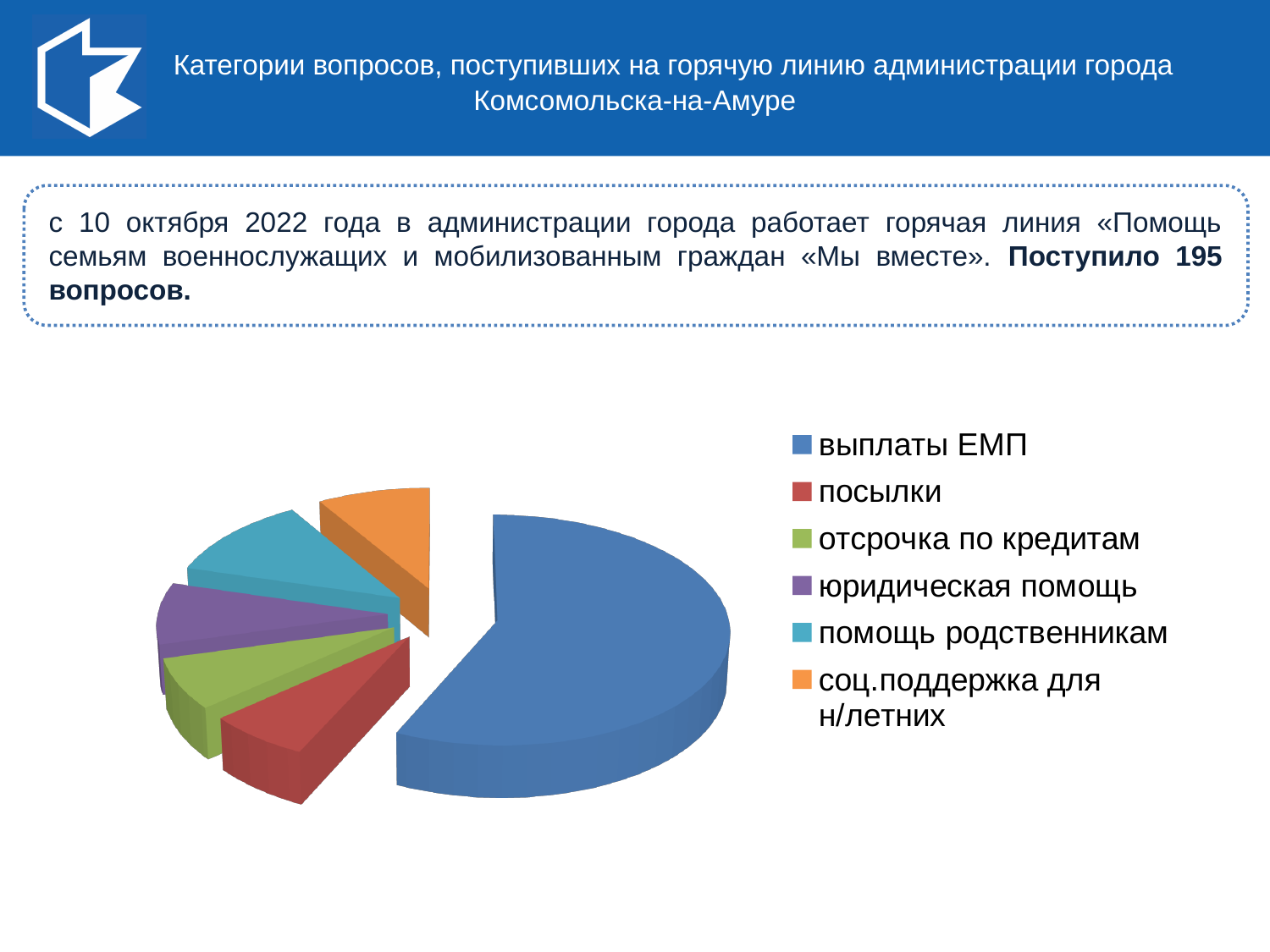
What colour is the slice for посылки in the pie chart? red Which is larger in the pie chart: выплаты ЕМП or соц.поддержка для н/летних? выплаты ЕМП How many categories does the pie chart show? 6 Which is larger in the pie chart: выплаты ЕМП or посылки? выплаты ЕМП Which is larger in the pie chart: выплаты ЕМП or юридическая помощь? выплаты ЕМП Which legend entry is shown in orange in the pie chart? соц.поддержка для н/летних Which category has the largest slice in the pie chart? выплаты ЕМП What kind of chart is shown on the slide? pie chart